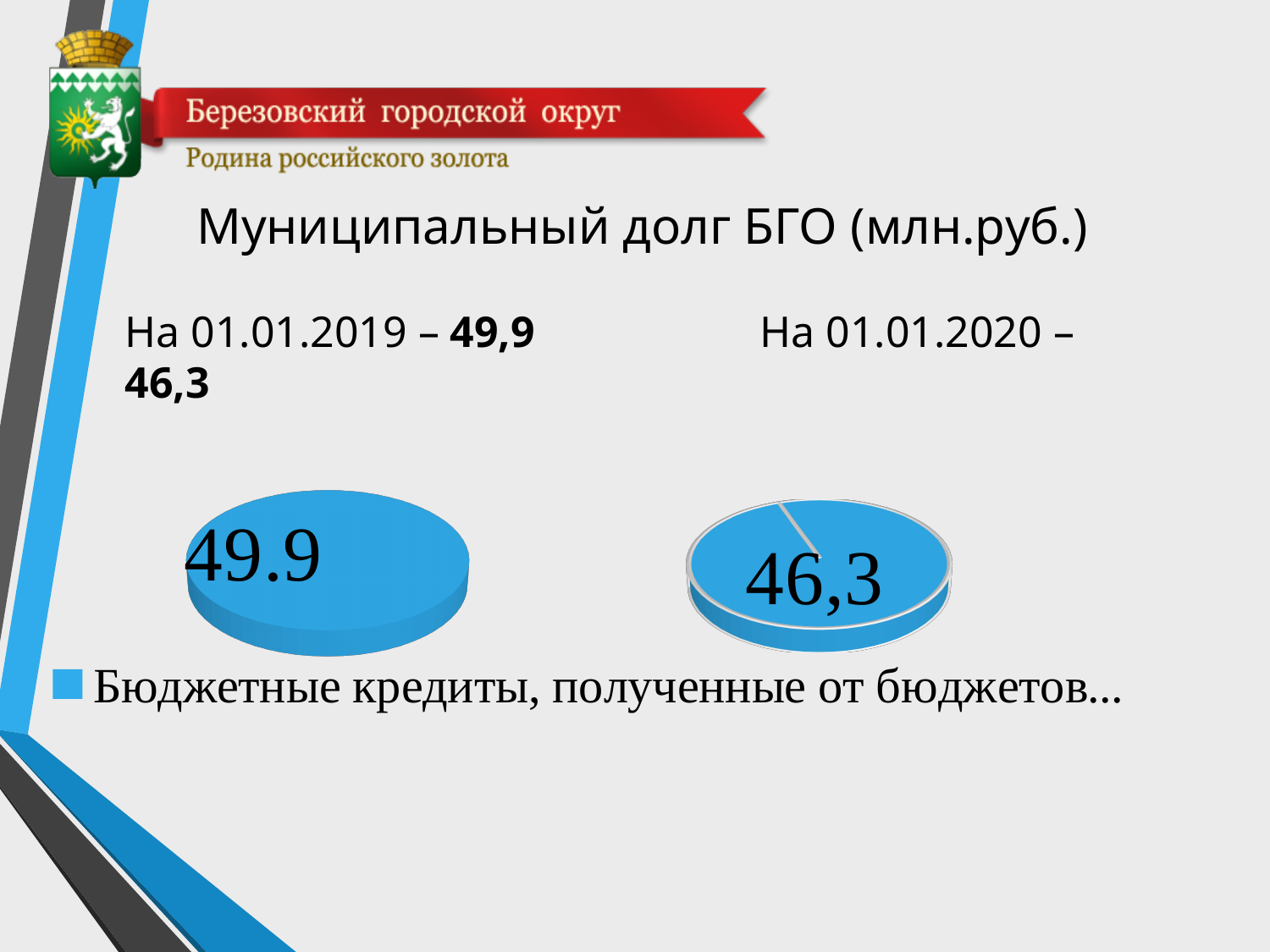
How many slices does the left pie chart have? 1 What kind of chart is shown on the left of the slide? pie chart What is the difference between the value on the left pie chart and the value on the right pie chart? 3,6 Did the municipal debt rise or fall from 01.01.2019 to 01.01.2020? fall Which pie chart shows the larger value, the left one or the right one? the left one On the left pie chart, what value is printed on the slice? 49.9 According to the slide text, what was the municipal debt of BGO on 01.01.2020 (million rubles)? 46,3 On the right pie chart, what value is printed on the slice? 46,3 What kind of chart is shown on the right of the slide? pie chart According to the slide text, what was the municipal debt of BGO on 01.01.2019 (million rubles)? 49,9 What share of the right pie chart does its single slice take up? 100% What is the legend entry shown below the pie charts? Бюджетные кредиты, полученные от бюджетов...